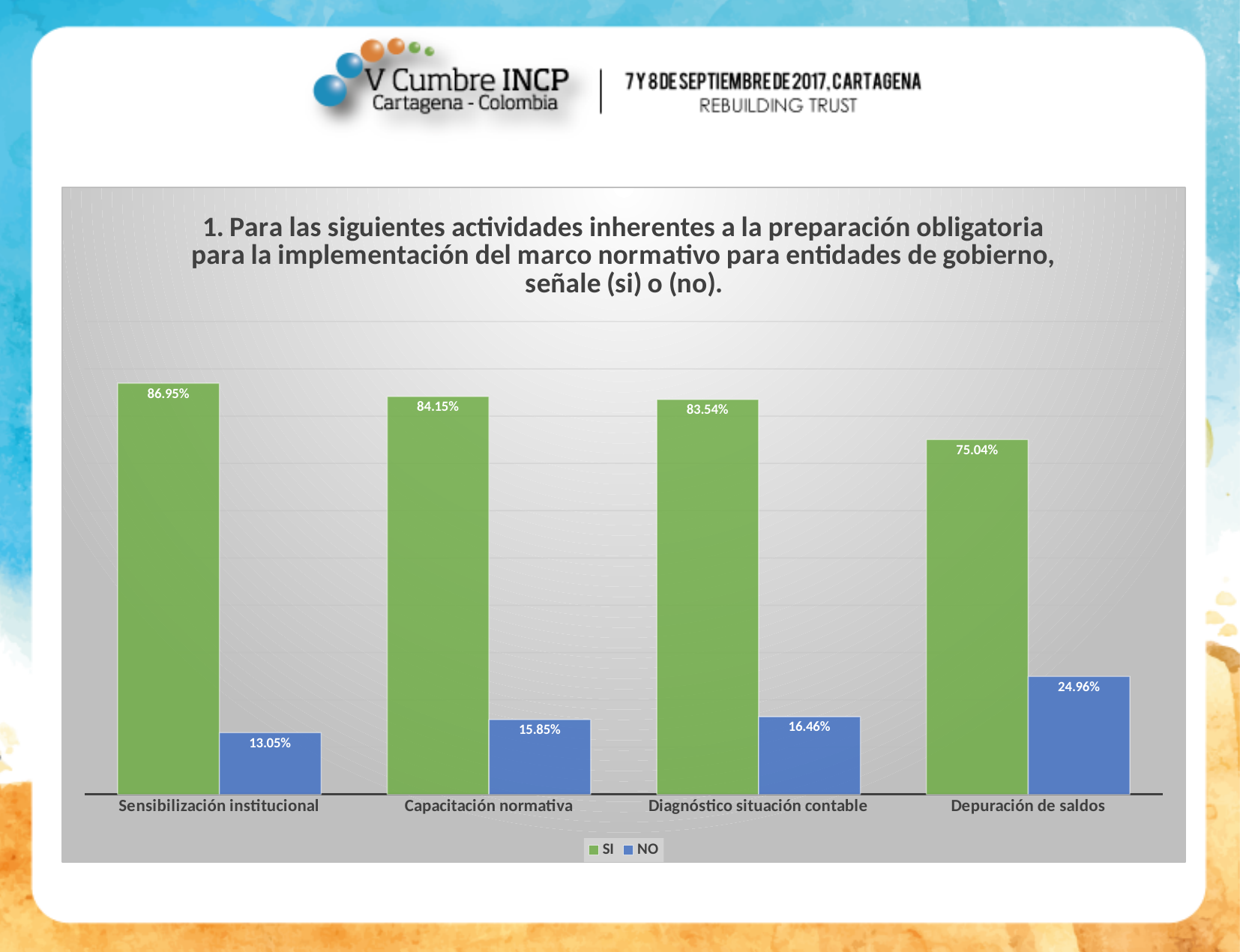
Which category has the lowest NO value? Sensibilización institucional What is the SI value for Sensibilización institucional? 86.95% What is the difference between the SI and NO values for Depuración de saldos? 50.08% How many categories are shown on the x axis? 4 What is the SI value for Diagnóstico situación contable? 83.54% What kind of chart is shown on the slide? Bar chart How many series does the legend list? 2 Which category has the highest SI value? Sensibilización institucional What is the NO value for Depuración de saldos? 24.96% Which is larger, the NO value for Diagnóstico situación contable or the NO value for Capacitación normativa? Diagnóstico situación contable What is the NO value for Capacitación normativa? 15.85% Which category has the highest NO value? Depuración de saldos